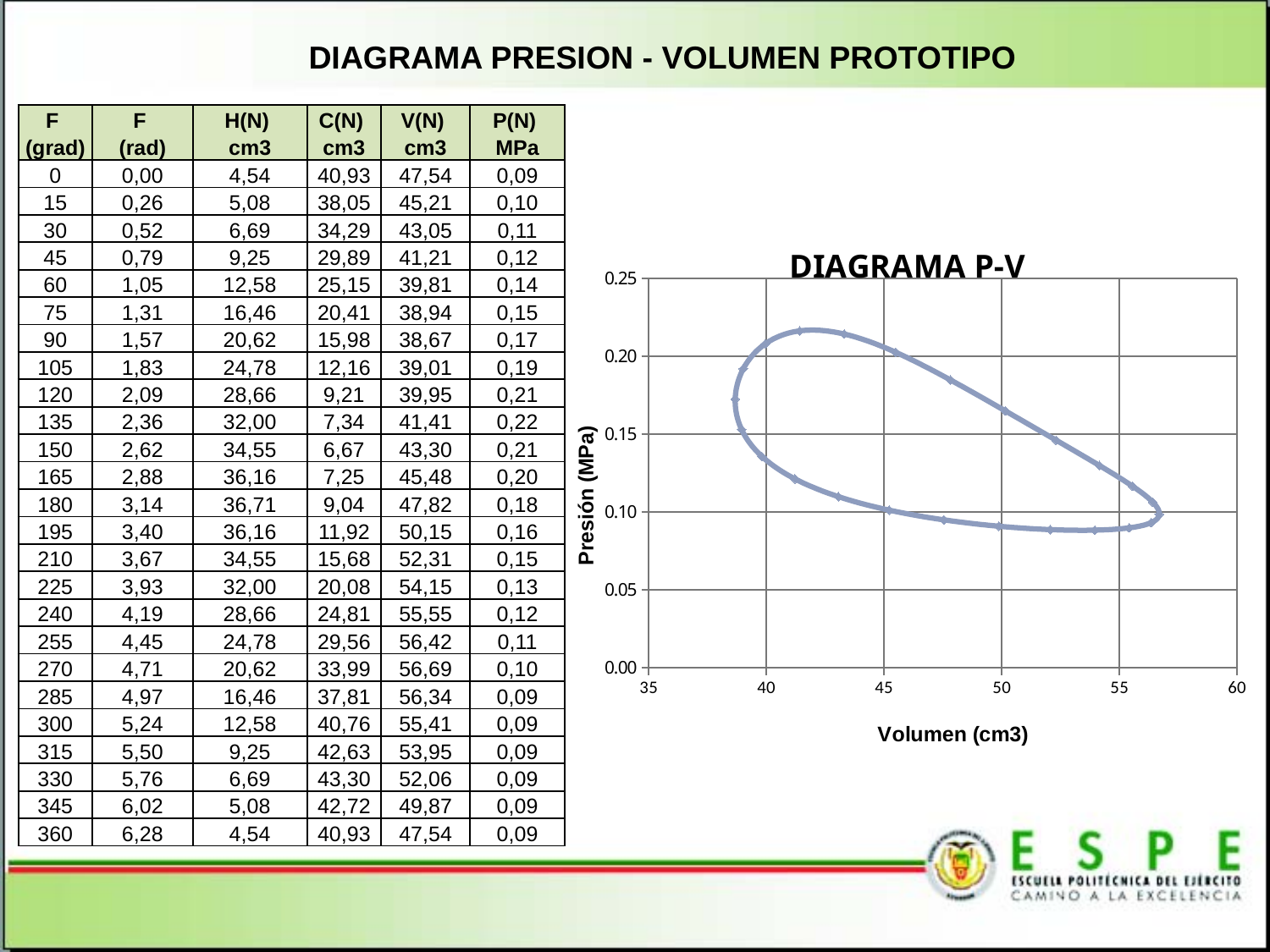
In the DIAGRAMA P-V chart, is the highest pressure reached by the curve greater or less than 0.20? greater In the DIAGRAMA P-V chart, is the smallest volume reached by the curve greater or less than 40? less In the DIAGRAMA P-V chart, is the pressure on the upper branch of the loop at a volume of 50 greater or less than 0.15? greater What kind of chart is the DIAGRAMA P-V chart? line chart In the DIAGRAMA P-V chart, which is larger: the pressure at the top of the loop near volume 42, or the pressure at the right end of the loop near volume 57? the pressure near volume 42 In the DIAGRAMA P-V chart, along the upper branch of the loop, does the pressure rise or fall as the volume increases from 42 to 57? fall What is the title of the chart on the right of the slide? DIAGRAMA P-V What is the highest value shown on the vertical axis of the DIAGRAMA P-V chart? 0.25 What is the label of the vertical axis of the DIAGRAMA P-V chart? Presión (MPa)